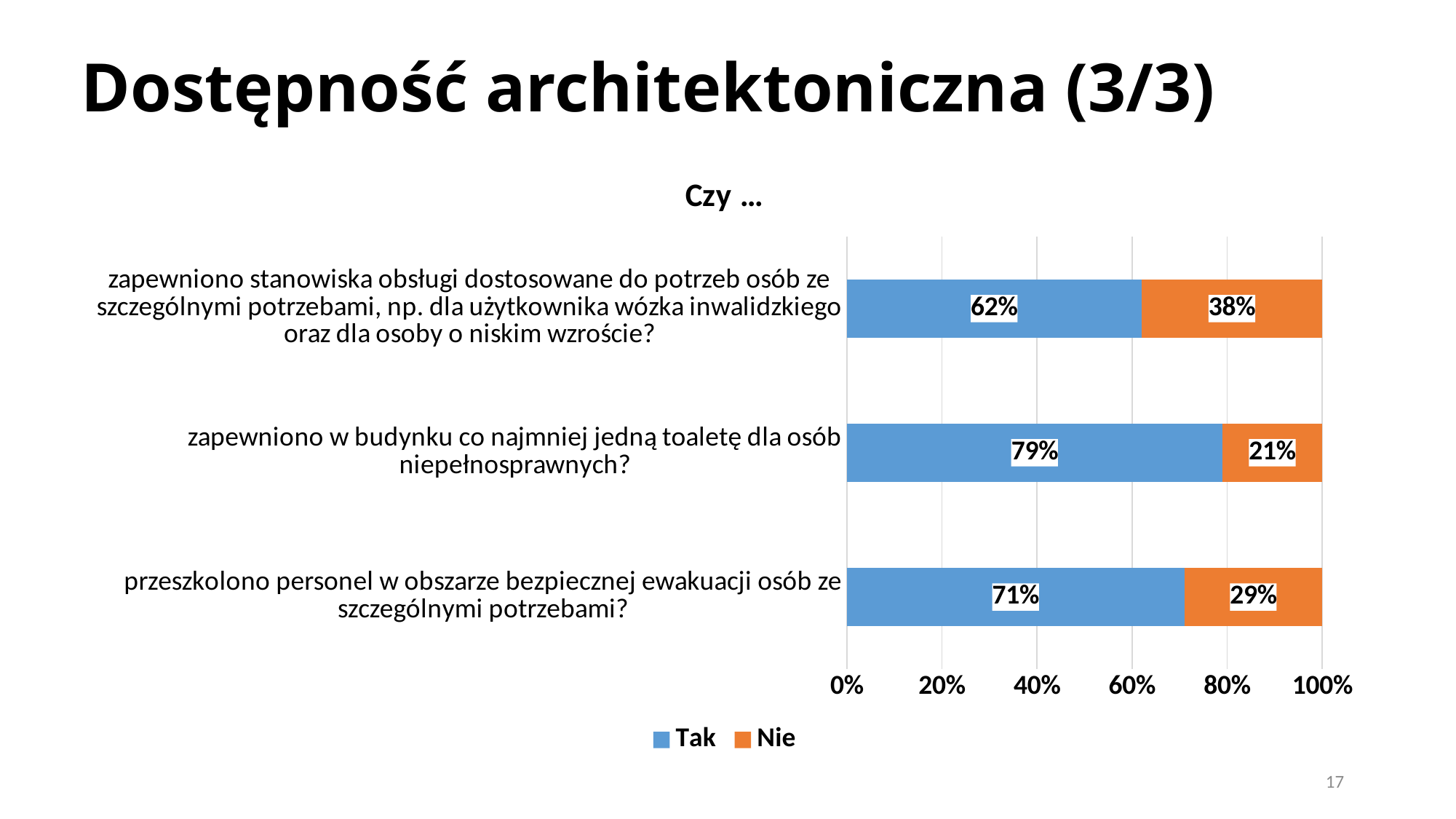
What is the 'Tak' value for the question about providing at least one toilet for disabled persons in the building (zapewniono w budynku co najmniej jedną toaletę dla osób niepełnosprawnych)? 79% What kind of chart is shown on the slide? stacked bar chart How many series does the legend list? 2 How many questions (categories) are shown in the chart? 3 Which is larger: the 'Nie' value for the service stations question or the 'Nie' value for the staff training question? the service stations question (38%) What is the 'Tak' value for the question about service stations adapted to the needs of people with special needs (zapewniono stanowiska obsługi dostosowane do potrzeb osób ze szczególnymi potrzebami)? 62% What is the 'Nie' value for the question about training staff in safe evacuation of people with special needs (przeszkolono personel w obszarze bezpiecznej ewakuacji)? 29% What is the 'Nie' value for the question about providing at least one toilet for disabled persons? 21% Which question has the highest 'Tak' share? zapewniono w budynku co najmniej jedną toaletę dla osób niepełnosprawnych? What is the total of the stacked bar for the staff training question (71% + 29%)? 100% What is the difference between the 'Tak' values for the toilet question (79%) and the staff training question (71%)? 8% Which question has the lowest 'Tak' share? zapewniono stanowiska obsługi dostosowane do potrzeb osób ze szczególnymi potrzebami, np. dla użytkownika wózka inwalidzkiego oraz dla osoby o niskim wzroście?